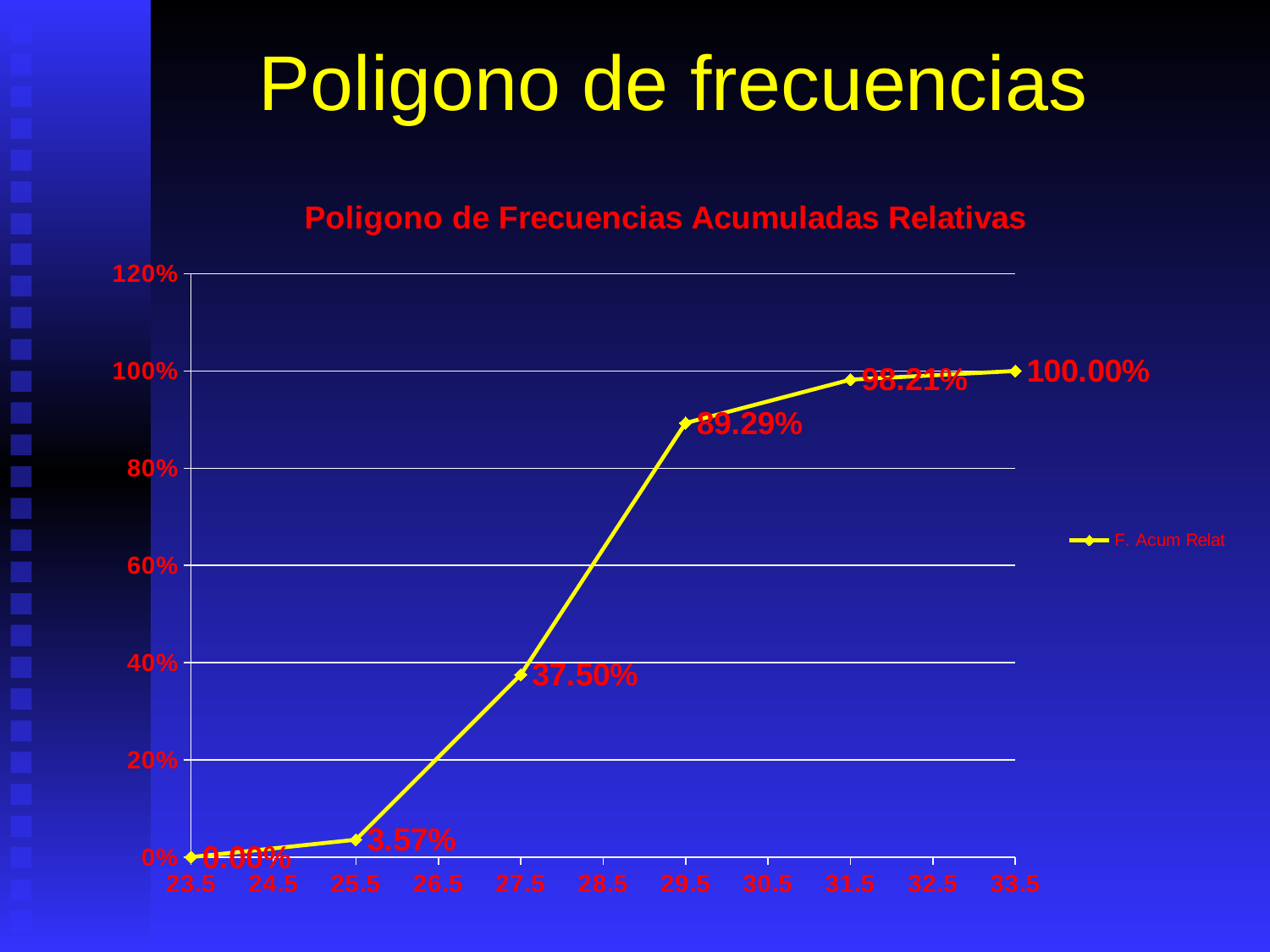
What is the value of F. Acum Relat at 27.5? 37.50% What is the title of the chart? Poligono de Frecuencias Acumuladas Relativas At which x value does the line reach its highest value? 33.5 What is the value of F. Acum Relat at 25.5? 3.57% How many data points are plotted on the line? 6 What is the value of F. Acum Relat at 29.5? 89.29% At which x value does the line have its lowest value? 23.5 Do the values rise or fall as the x axis increases? Rise What is the value of F. Acum Relat at 31.5? 98.21% What type of chart is shown on the slide? Line chart What is the difference between the values at 29.5 and 27.5? 51.79% Which is larger, the value at 25.5 or the value at 27.5? 27.5